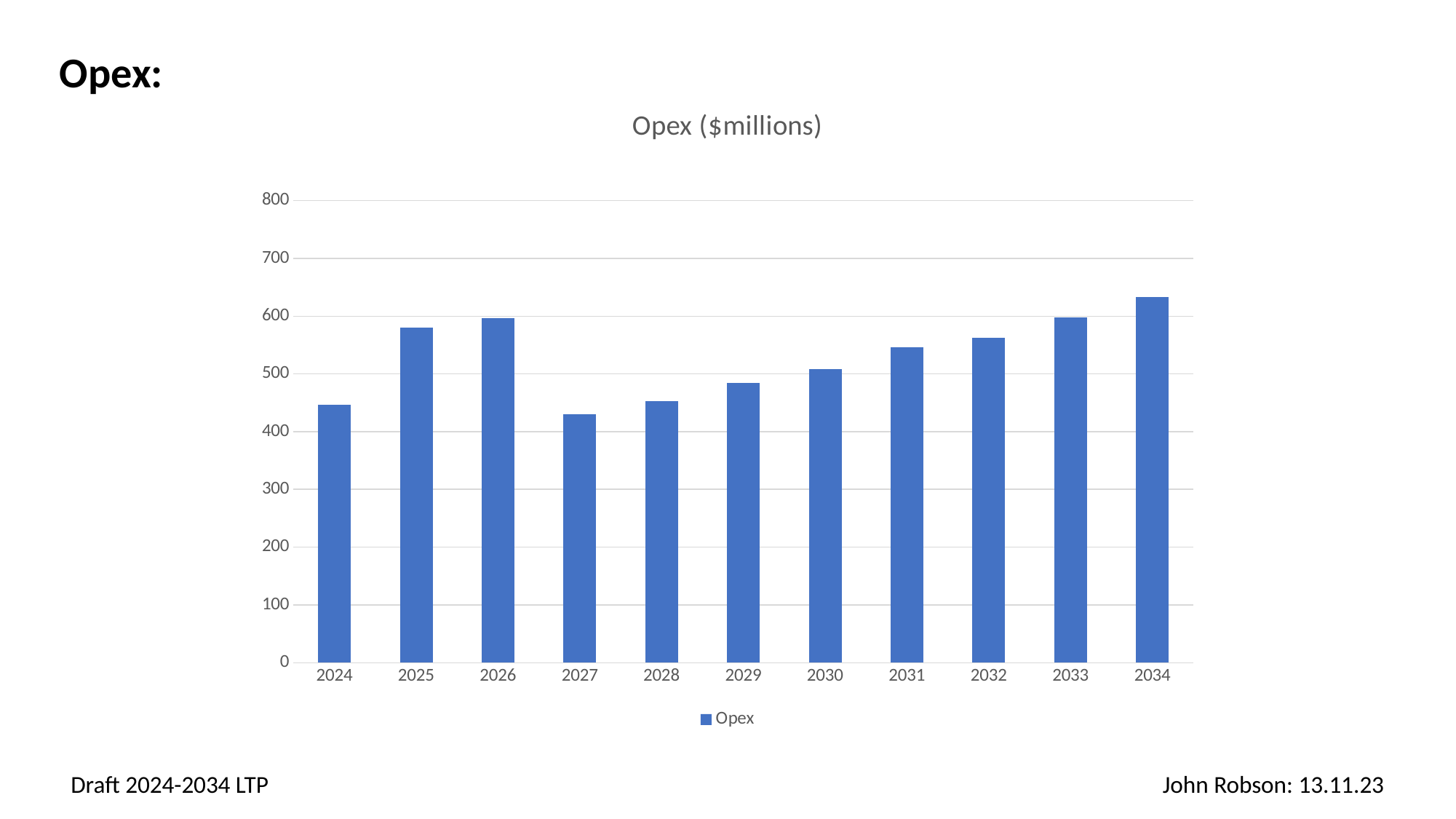
Do the Opex values rise or fall from 2027 to 2034? rise How many years are shown on the x axis of the chart? 11 Is the Opex value for 2031 greater or less than 500? greater Which year has the lowest Opex? 2027 Which year has the highest Opex? 2034 How many series does the legend list? 1 What is the title of the chart? Opex ($millions) Is the Opex value for 2034 greater or less than 600? greater What type of chart is shown on the slide? Bar chart Which year has the larger Opex, 2030 or 2031? 2031 Is the Opex value for 2025 greater or less than 600? less